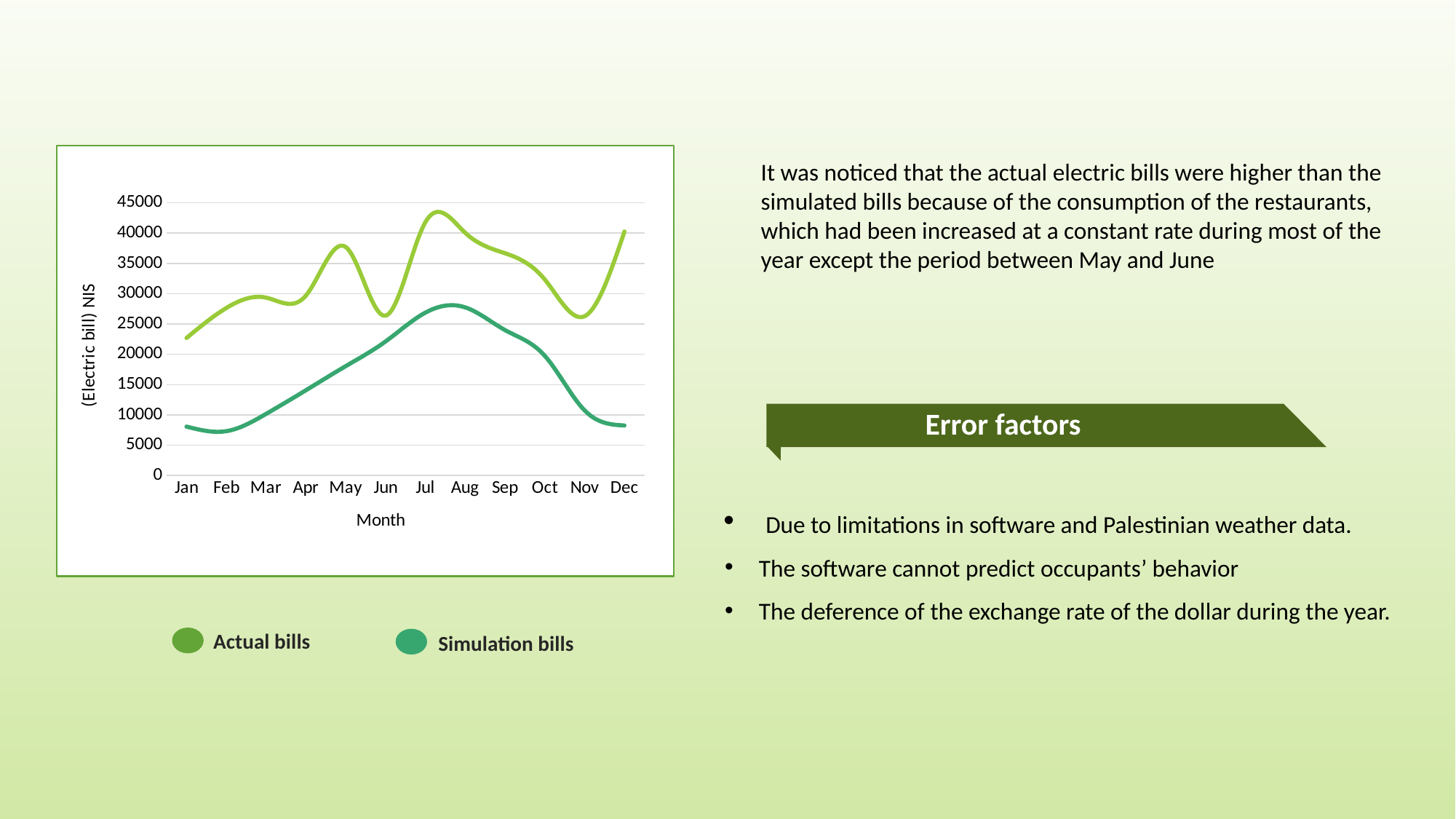
How many series does the legend list? 2 How many months are plotted along the x axis? 12 What is the label on the y axis of the chart? (Electric bill) NIS What kind of chart is shown on the slide? line chart Is the value for Simulation bills in Jan greater or less than 10000? less Which series has the larger value in Jul, Actual bills or Simulation bills? Actual bills In which month are the Actual bills lowest? Jan Is the value for Simulation bills in Aug greater or less than 25000? greater Is the value for Actual bills in May greater or less than 35000? greater Do the Simulation bills rise or fall from Aug to Dec? fall In which month are the Actual bills highest? Jul